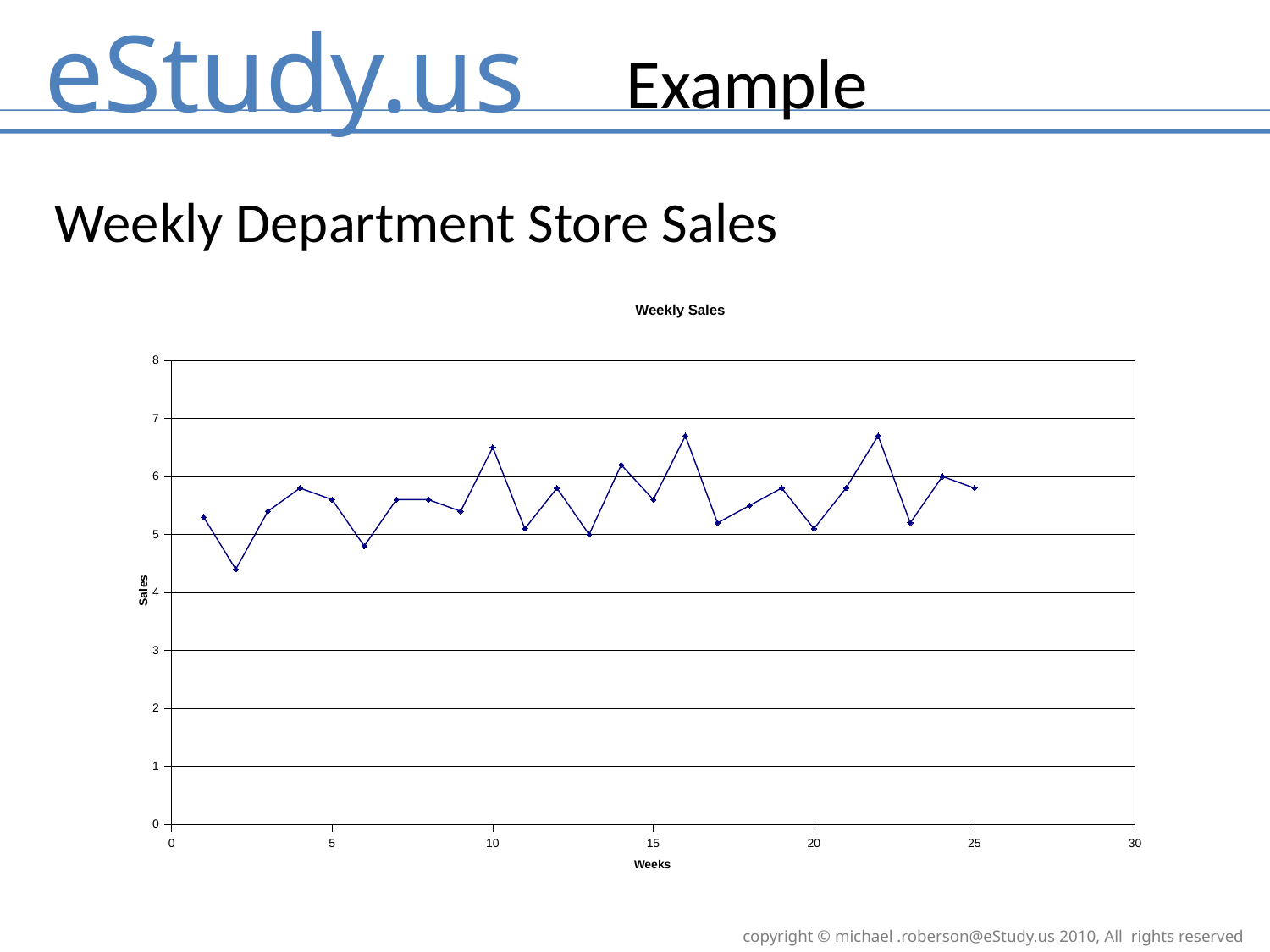
Which has the higher sales value, week 2 or week 6? week 6 What kind of chart is shown on the slide? line chart Is the sales value for week 16 greater or less than 6? greater Is the sales value for week 6 greater or less than 5? less Is the sales value for week 25 greater or less than 6? less How many weekly data points are plotted on the chart? 25 Which week has the lowest sales value? week 2 What is the title of the chart? Weekly Sales What is the label on the x axis of the chart? Weeks Which has the higher sales value, week 10 or week 11? week 10